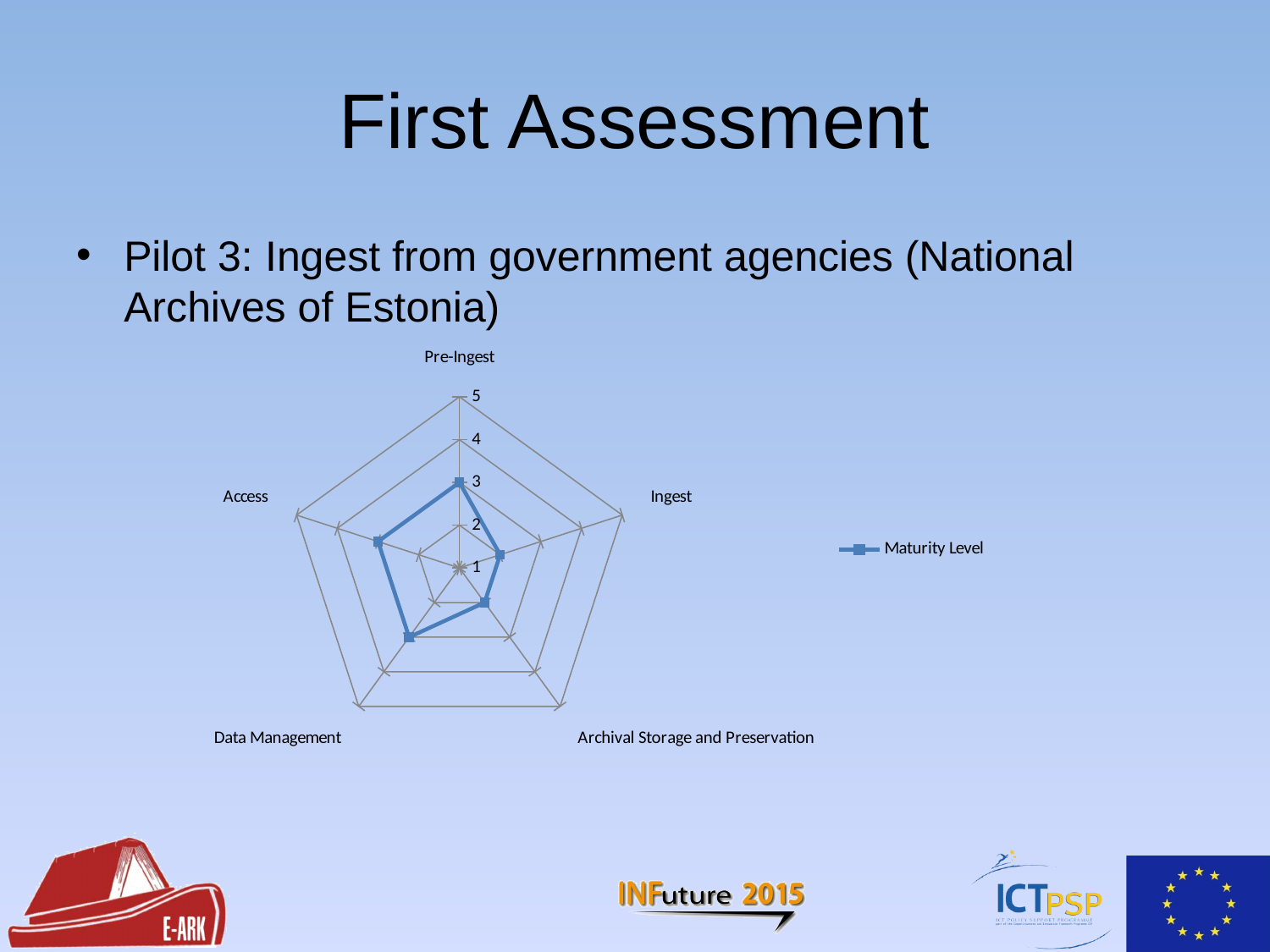
What is the Maturity Level for Data Management? 3 What kind of chart is shown on the slide? Radar chart Is the Maturity Level for Ingest greater or less than 3? less How many series does the legend of the radar chart list? 1 What is the highest value shown on the radar chart's axis scale? 5 What is the Maturity Level for Ingest? 2 What is the Maturity Level for Pre-Ingest? 3 What is the Maturity Level for Archival Storage and Preservation? 2 What is the name of the series shown in the legend of the radar chart? Maturity Level How many categories (axes) does the radar chart have? 5 Which has a higher Maturity Level, Pre-Ingest or Ingest? Pre-Ingest What is the difference between the Maturity Level for Access and for Archival Storage and Preservation? 1